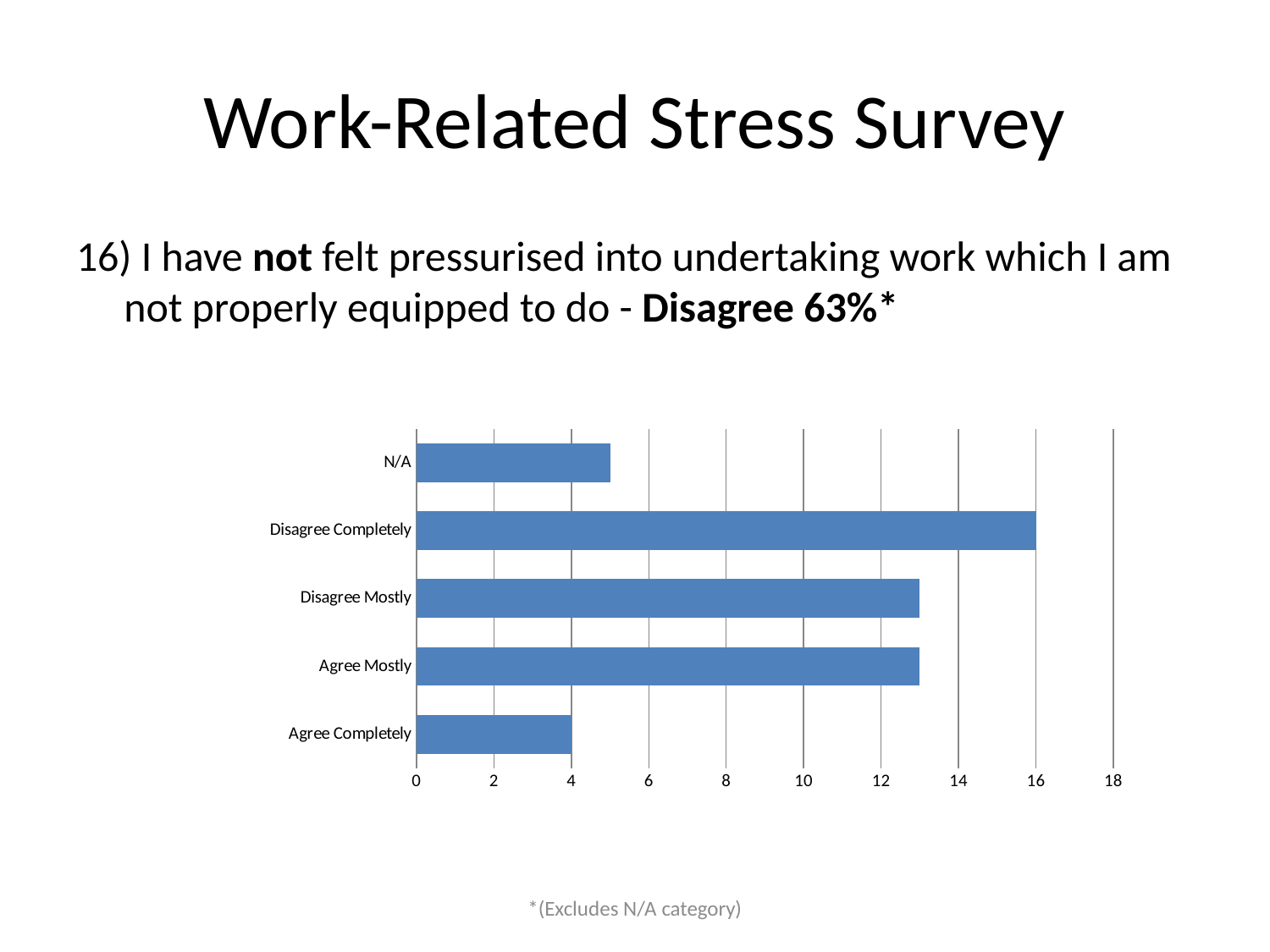
What kind of chart is shown on the slide? bar chart How many categories are plotted in the chart? 5 Which is larger, the value for N/A or the value for Agree Completely? N/A What is the highest value shown on the horizontal axis of the chart? 18 Is the value for N/A greater or less than 6? less What is the value for Agree Completely? 4 What is the difference between the values for Disagree Completely and Agree Completely? 12 Is the value for Disagree Mostly greater or less than 12? greater Which category has the lowest value in the chart? Agree Completely What is the value for Disagree Completely? 16 Is the value for Agree Mostly greater or less than 14? less Which category has the highest value in the chart? Disagree Completely